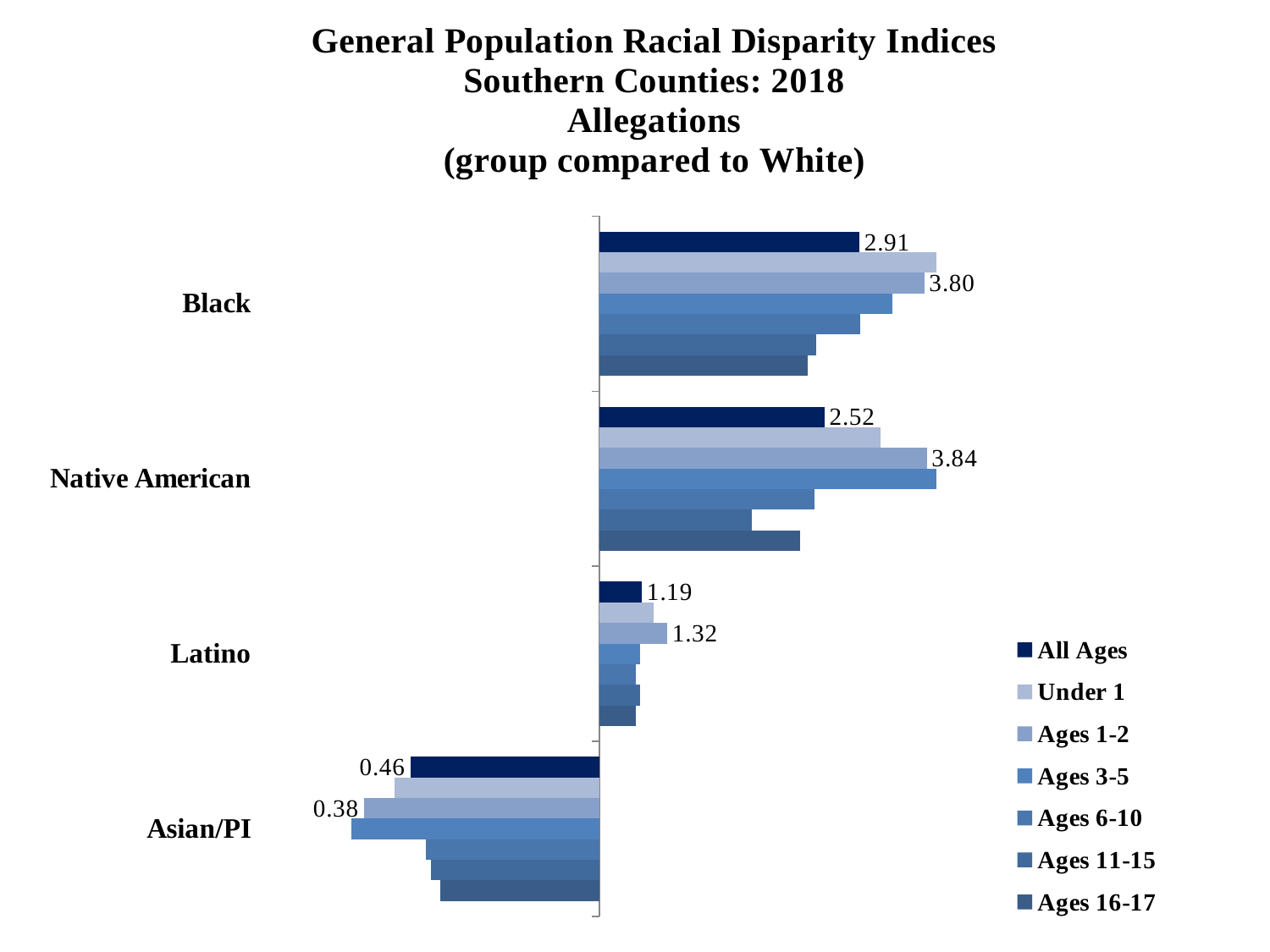
What is the difference between the Ages 1-2 index and the All Ages index for Latino? 0.13 How many series does the legend list? 7 How many racial groups are shown on the chart? 4 What is the All Ages disparity index for Latino? 1.19 Which is larger: the Ages 1-2 index for Black or the Ages 1-2 index for Native American? Native American What is the difference between the All Ages index for Black and the All Ages index for Native American? 0.39 What is the All Ages disparity index for Black? 2.91 What is the Ages 1-2 disparity index for Asian/PI? 0.38 Which group has the highest All Ages disparity index? Black What kind of chart is shown on the slide? Bar chart Which group has the lowest All Ages disparity index? Asian/PI What is the Ages 1-2 disparity index for Native American? 3.84